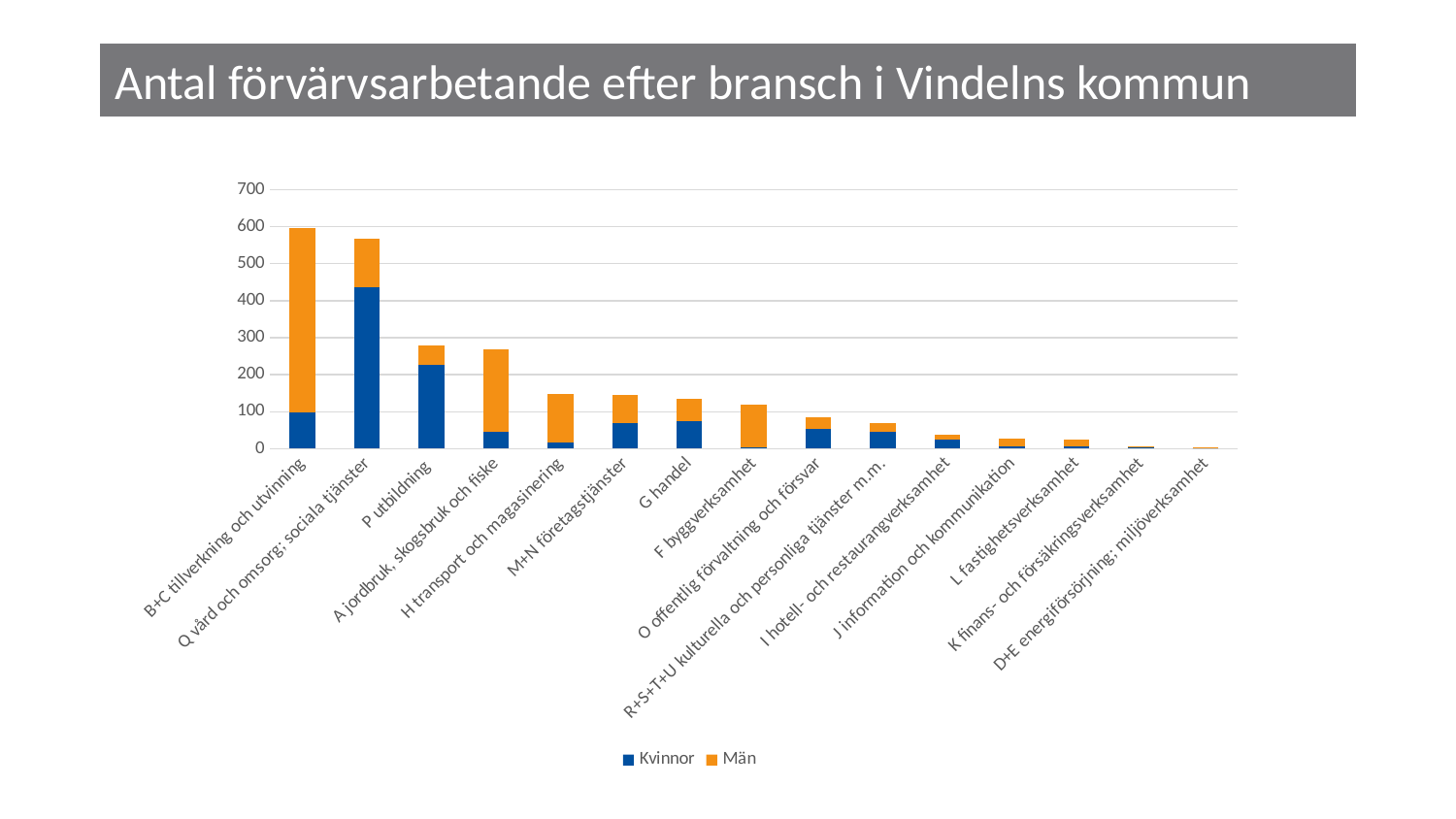
How many series does the legend list? 2 Is the total value for H transport och magasinering greater or less than 200? less Is the Kvinnor value for Q vård och omsorg; sociala tjänster greater or less than 400? greater How many industry categories are shown on the x axis? 15 Which category has the largest Kvinnor segment? Q vård och omsorg; sociala tjänster Which category has the smallest stacked bar overall? D+E energiförsörjning; miljöverksamhet What kind of chart is shown on the slide? Stacked bar chart Do the total bar heights generally rise or fall from left to right along the x axis? fall Is the total value for B+C tillverkning och utvinning greater or less than 500? greater Which series is shown in orange in the legend? Män Which category has the tallest stacked bar overall? B+C tillverkning och utvinning